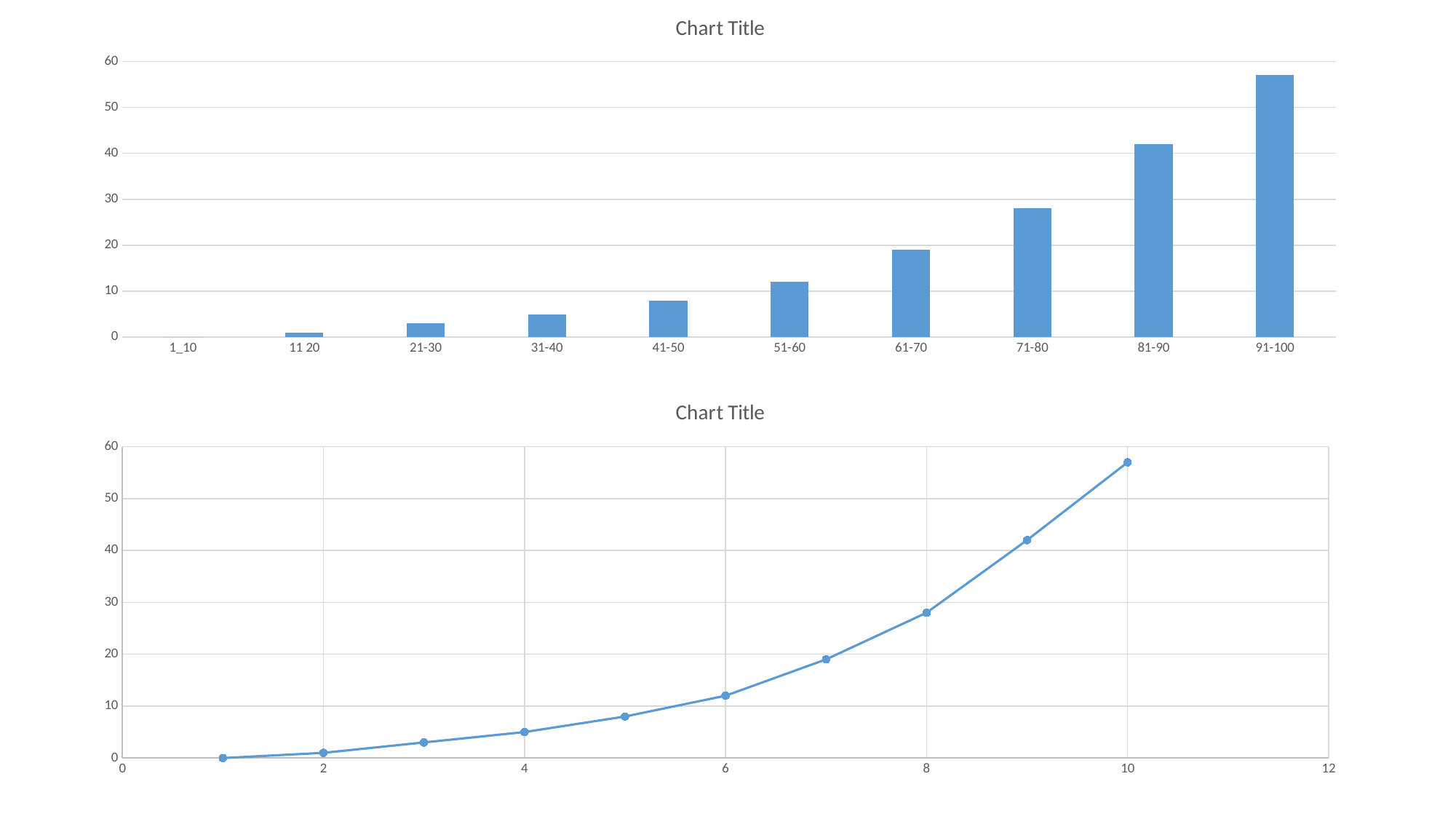
In the bottom chart, how many data points are plotted? 10 In the top chart, which category has the highest bar? 91-100 What kind of chart is the bottom chart on the slide? line chart In the top chart, is the value for 71-80 greater or less than 30? less In the top chart, which category has the lowest bar? 1_10 What kind of chart is the top chart on the slide? bar chart In the top chart, which is larger, the bar for 61-70 or the bar for 41-50? 61-70 In the bottom chart, do the values rise or fall as x increases? rise In the top chart, is the value for 51-60 greater or less than 10? greater In the bottom chart, is the value at x = 8 greater or less than 30? less In the top chart, how many categories are shown on the x axis? 10